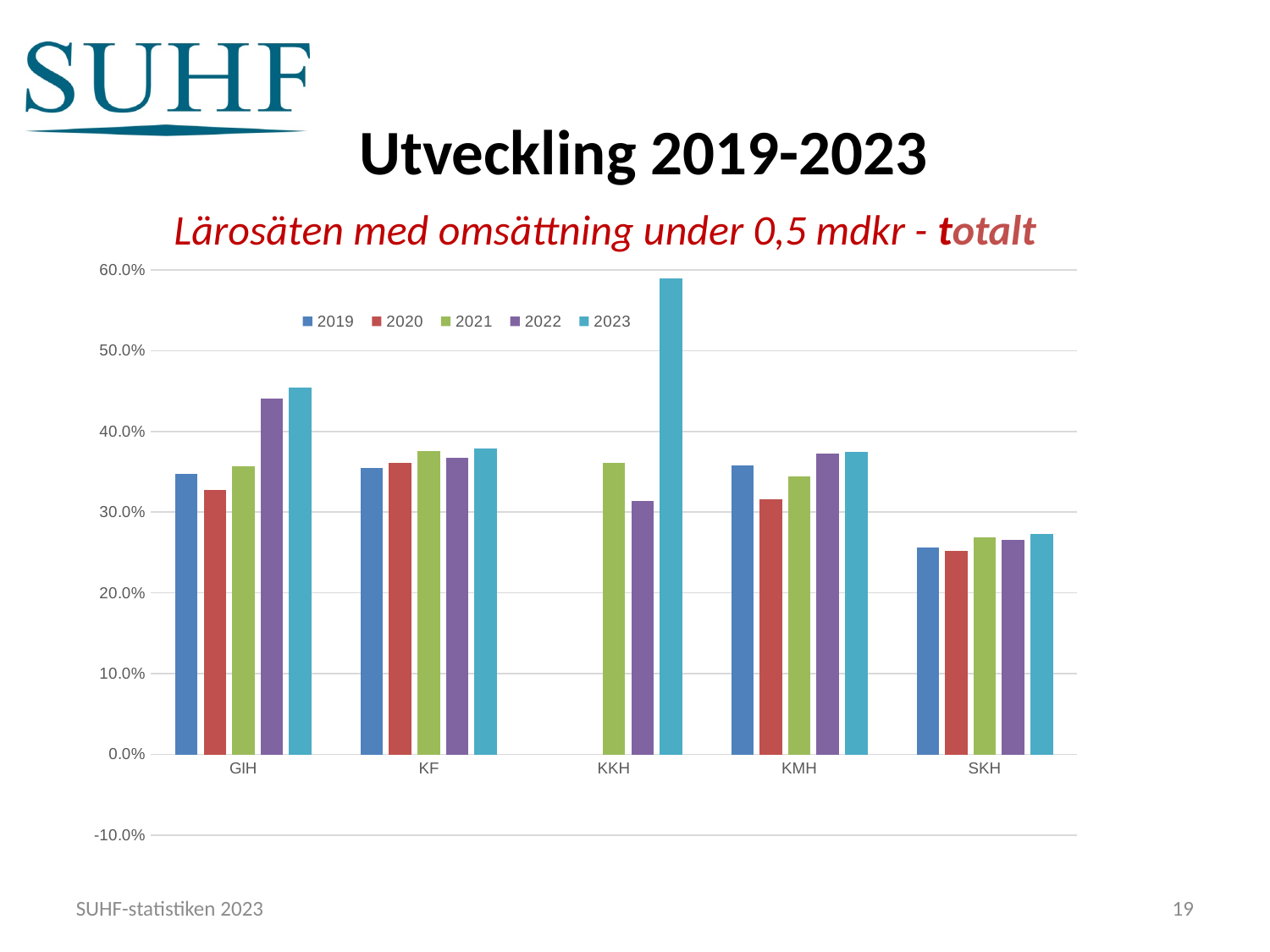
Which is larger for KKH, the 2021 value or the 2022 value? 2021 Which category has the highest bar in the chart? KKH Is the value for KKH in 2023 greater or less than 50.0%? greater Is the value for GIH in 2023 greater or less than 40.0%? greater Which category has the lowest bars overall? SKH Do the values for GIH rise or fall from 2020 to 2023? rise Which is larger, the 2023 value for GIH or the 2023 value for KF? GIH Which category is missing bars for 2019 and 2020? KKH How many series does the legend list? 5 How many categories are shown on the x axis? 5 What kind of chart is shown on the slide? bar chart Is the value for SKH in 2019 greater or less than 30.0%? less